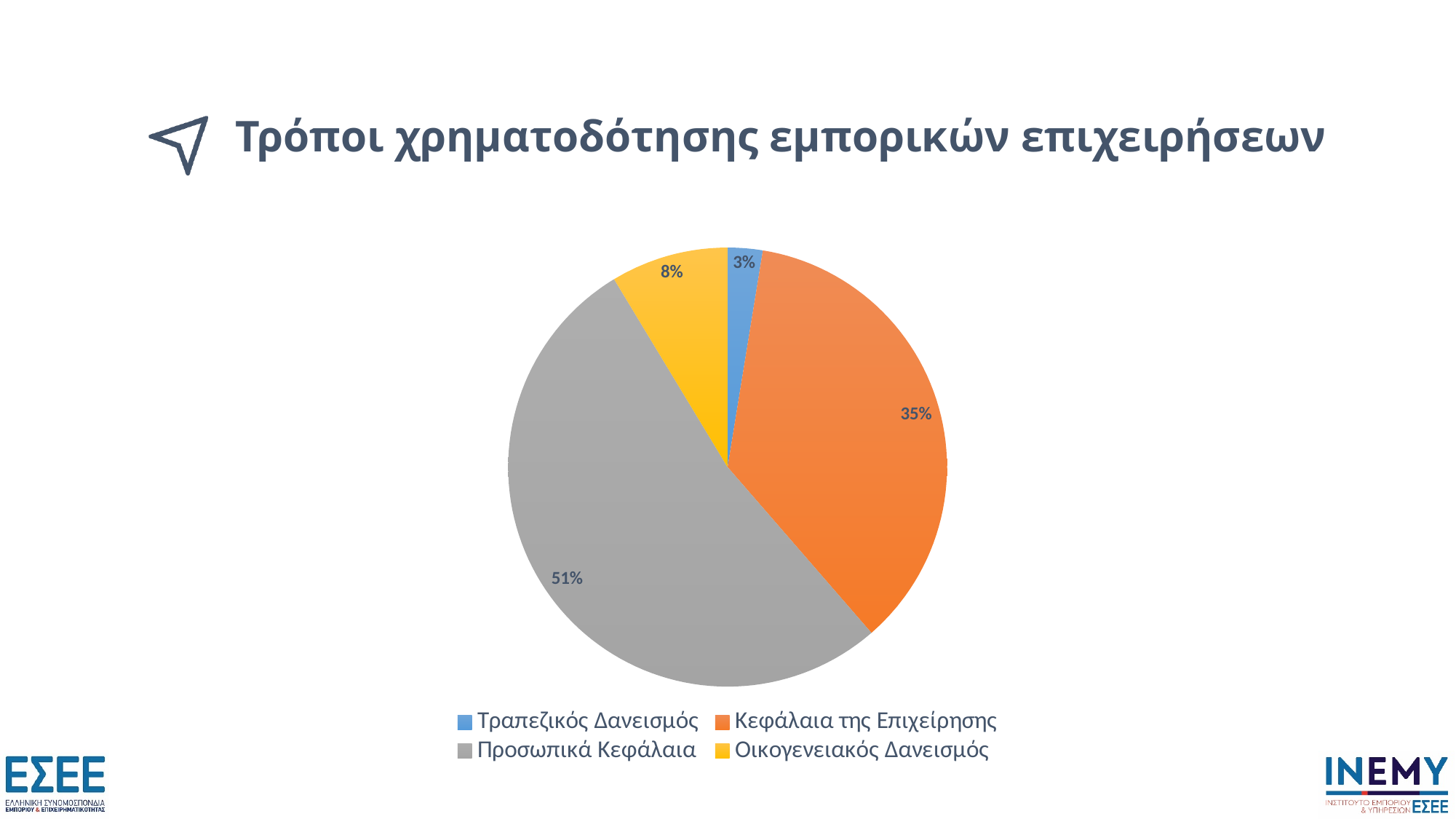
What kind of chart is shown on the slide? Pie chart What colour is the slice for Κεφάλαια της Επιχείρησης? Orange Which is larger, Οικογενειακός Δανεισμός or Τραπεζικός Δανεισμός? Οικογενειακός Δανεισμός What share of the pie does Προσωπικά Κεφάλαια represent? 51% Which category has the smallest slice of the pie? Τραπεζικός Δανεισμός What is the value shown for Οικογενειακός Δανεισμός? 8% What is the value shown for Κεφάλαια της Επιχείρησης? 35% What is the title of the chart? Τρόποι χρηματοδότησης εμπορικών επιχειρήσεων How many categories are shown in the pie chart? 4 What is the value shown for Τραπεζικός Δανεισμός? 3% Which category has the largest slice of the pie? Προσωπικά Κεφάλαια What is the difference in percentage points between Προσωπικά Κεφάλαια and Κεφάλαια της Επιχείρησης? 16